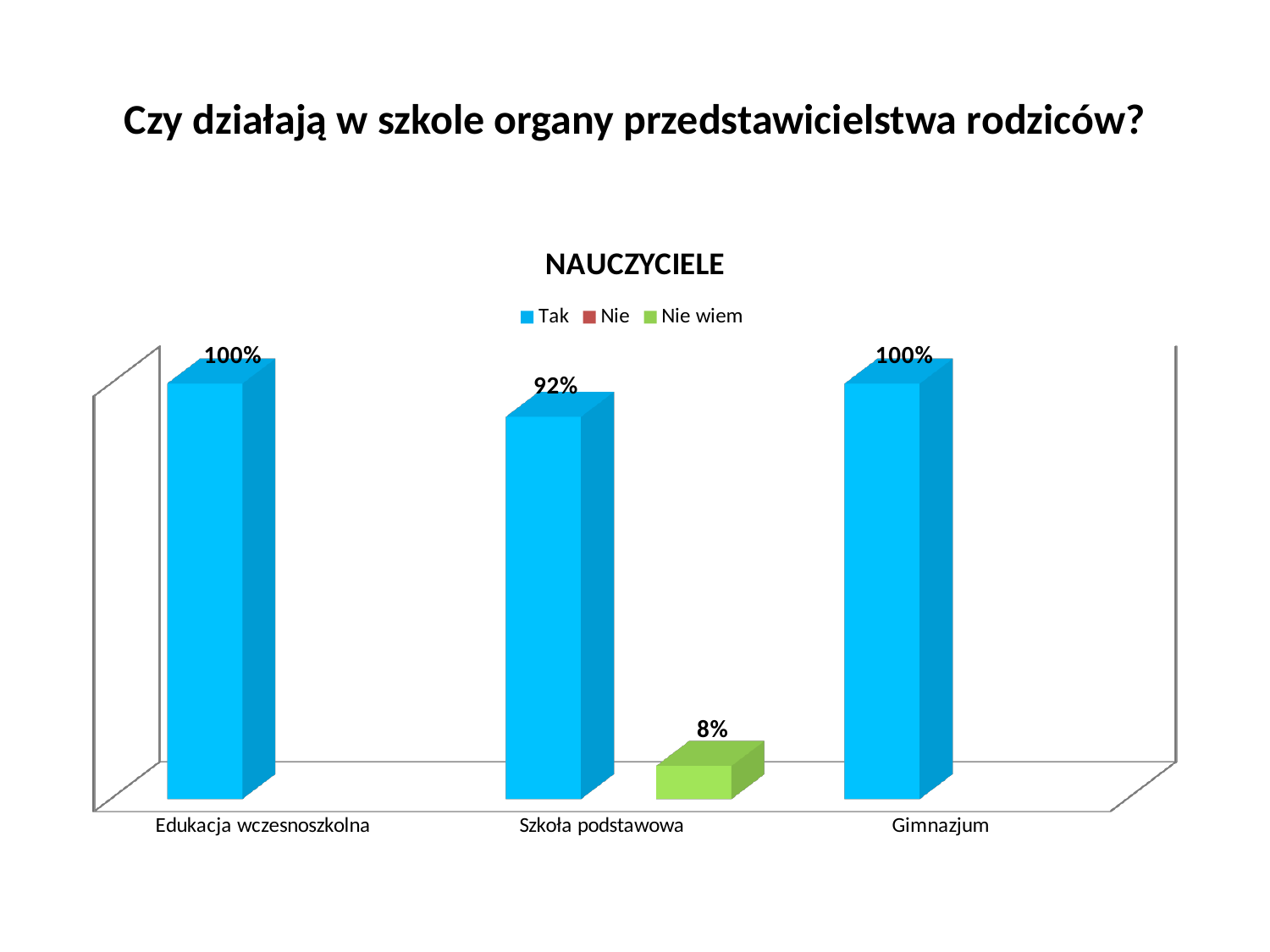
What is the value of "Tak" for Szkoła podstawowa? 92% What is the title of the chart? NAUCZYCIELE How many categories are shown on the x axis? 3 What is the value of "Tak" for Gimnazjum? 100% Which colour represents the "Nie wiem" series in the legend? Green Which is larger for Szkoła podstawowa: "Tak" or "Nie wiem"? Tak How many series does the legend list? 3 What is the difference between the "Tak" and "Nie wiem" values for Szkoła podstawowa? 84% Which category has the lowest "Tak" value? Szkoła podstawowa What is the value of "Tak" for Edukacja wczesnoszkolna? 100% What kind of chart is shown? Bar chart What is the value of "Nie wiem" for Szkoła podstawowa? 8%